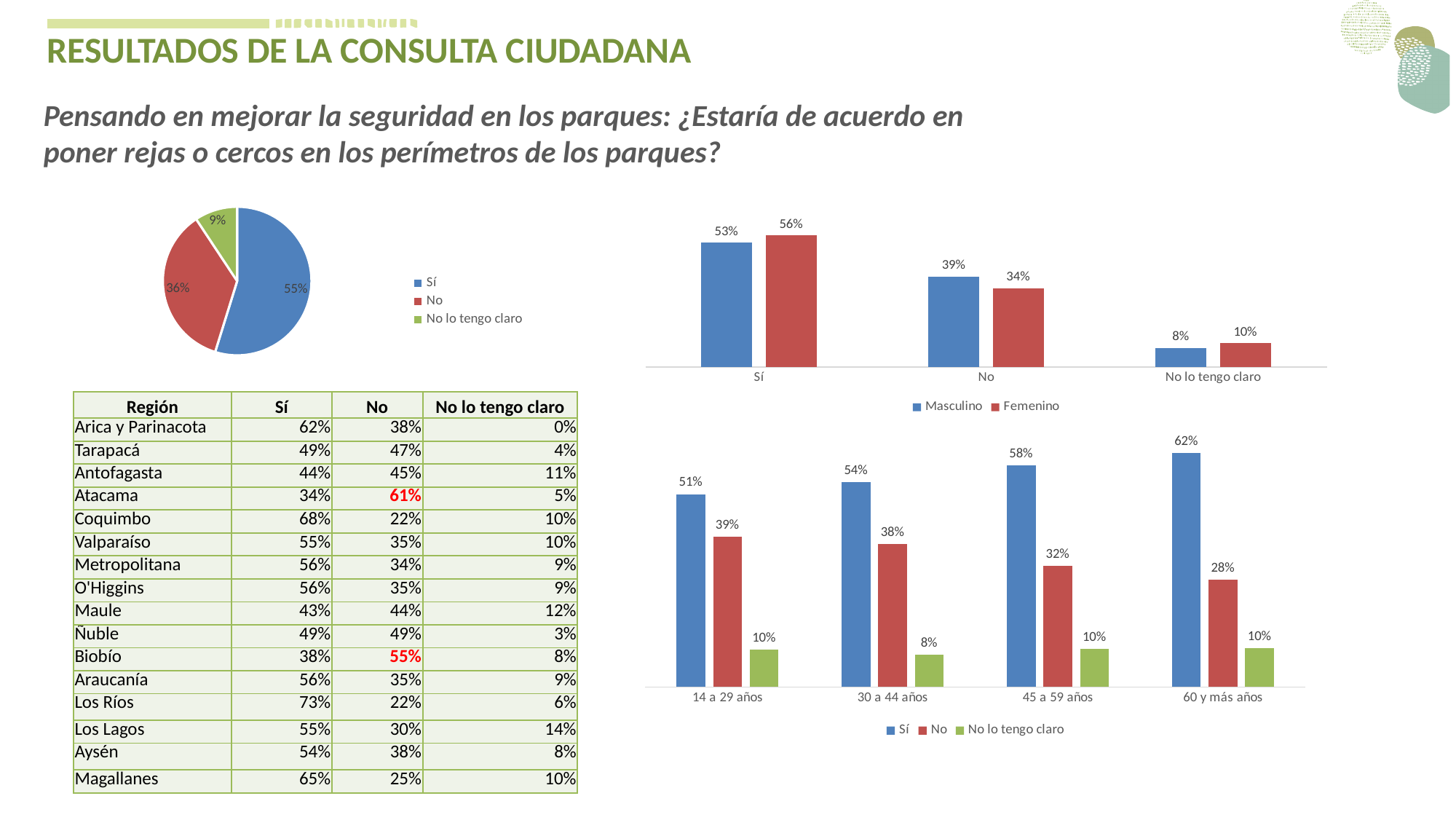
In the top-right bar chart by gender, how many series does the legend list? 2 In the pie chart on the left, how many slices are there? 3 What kind of chart is the bottom-right chart by age group? bar chart In the pie chart on the left, what share of responses is 'No lo tengo claro'? 9% In the bottom-right bar chart by age group, which age group has the highest 'Sí' value? 60 y más años In the bottom-right bar chart by age group, what is the 'Sí' value for '60 y más años'? 62% In the top-right bar chart by gender, what is the value for Femenino in the 'Sí' category? 56% In the top-right bar chart by gender, what is the value for Masculino in the 'No' category? 39% In the top-right bar chart by gender, what is the difference between Masculino and Femenino in the 'No' category? 5% In the bottom-right bar chart by age group, does the 'Sí' value rise or fall as age increases along the x axis? rise In the bottom-right bar chart by age group, which age group has the lowest 'No lo tengo claro' value? 30 a 44 años In the pie chart on the left, what share of responses is 'Sí'? 55%